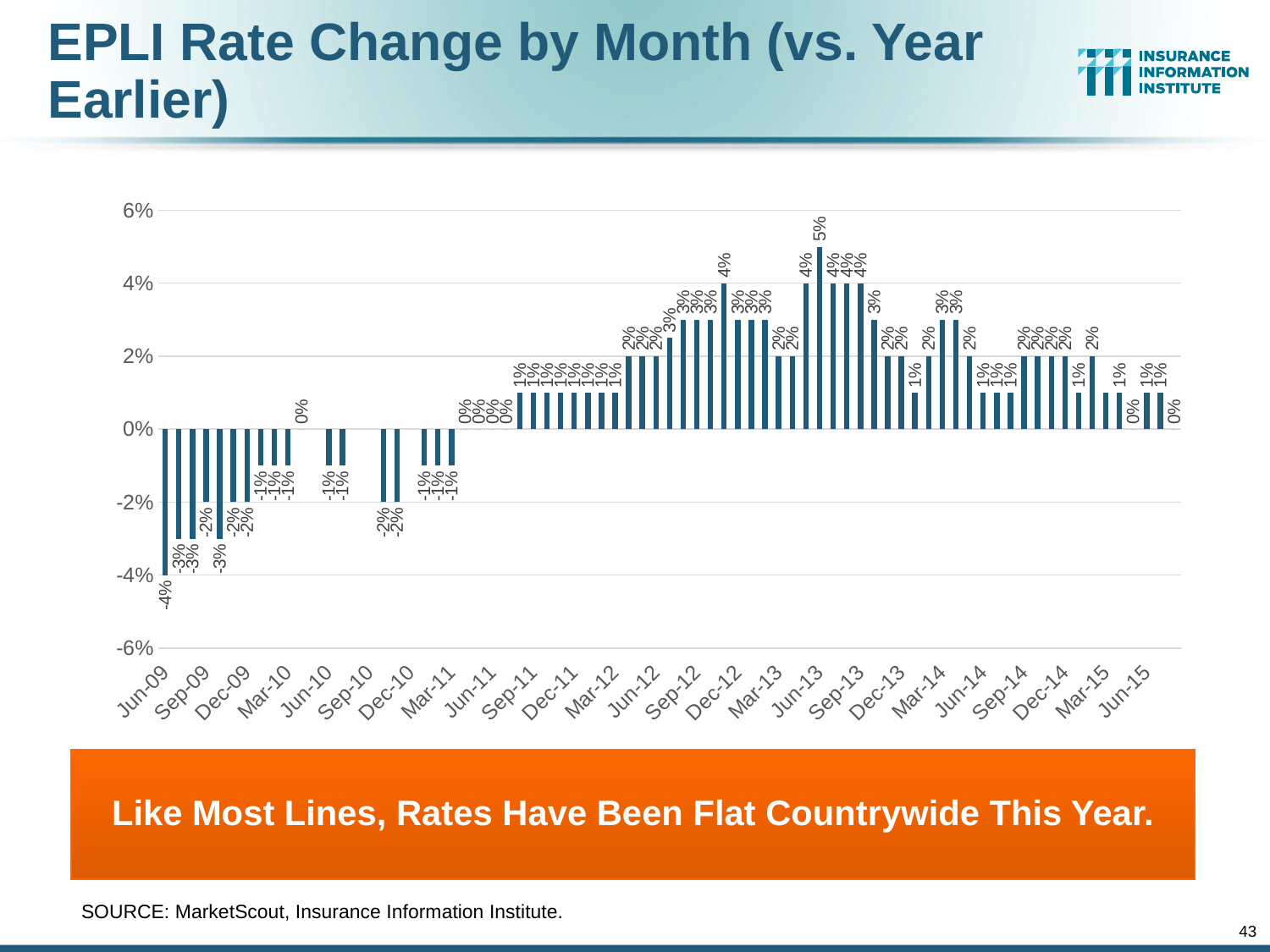
What is the EPLI rate change for Jun-09? -4% Which month has the lowest EPLI rate change? Jun-09 What kind of chart is shown on the slide? bar chart What is the highest value shown on the vertical axis? 6% Do the EPLI rate changes generally rise or fall from Jun-09 to Jun-13? rise Which month has the highest EPLI rate change? Jun-13 What is the title of the chart? EPLI Rate Change by Month (vs. Year Earlier) What is the EPLI rate change for Jun-13? 5% What is the difference between the highest value (5%) and the lowest value (-4%) on the chart? 9 percentage points Which is larger, the rate change for Jun-09 or for Jun-15? Jun-15 What is the EPLI rate change for Jun-15, the last month shown? 1% Is the value for Jun-13 greater or less than 4%? greater